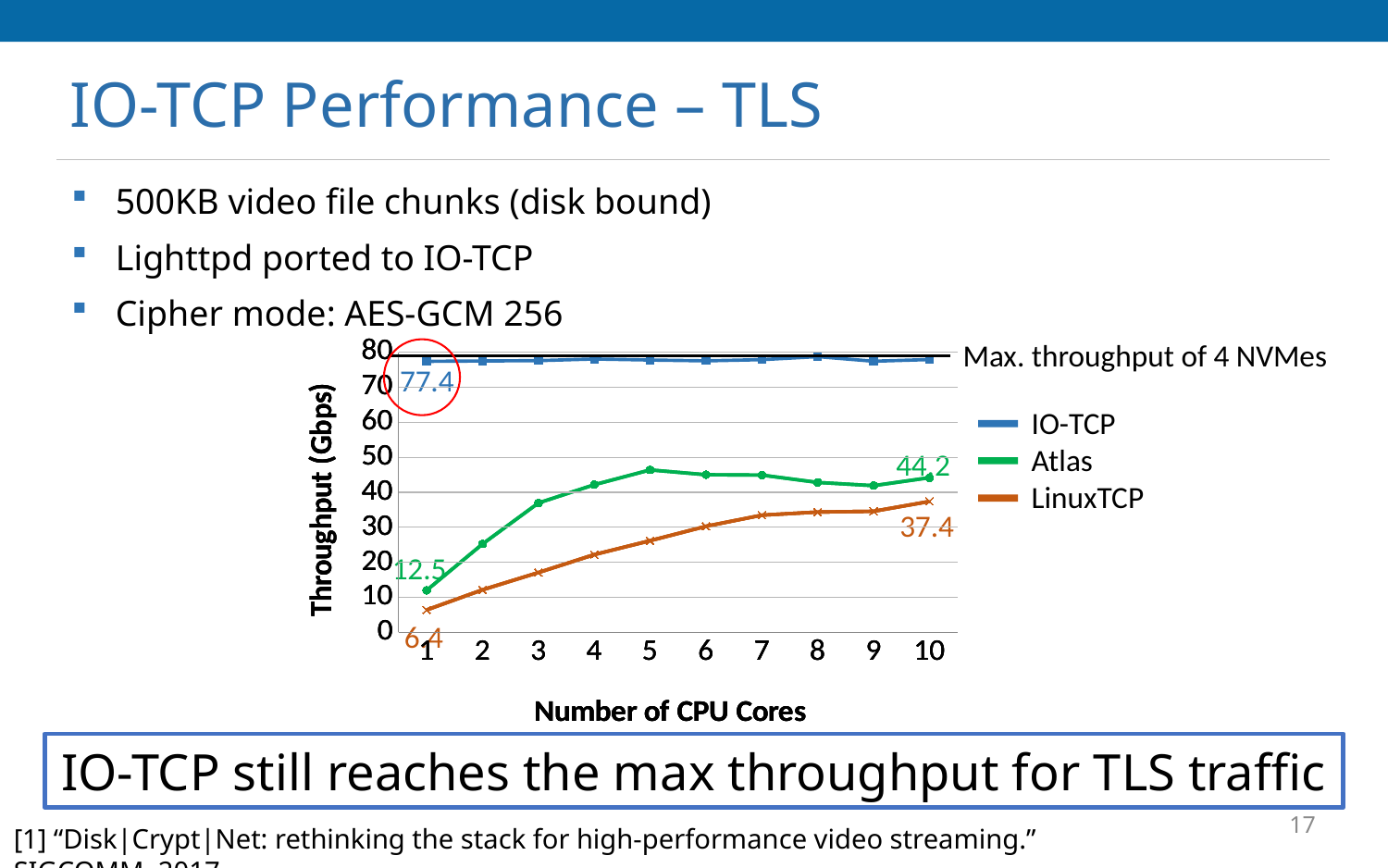
What is the throughput of Atlas at 10 CPU cores? 44.2 What kind of chart is shown on the slide? line chart What is the throughput of Atlas at 1 CPU core? 12.5 Which series has the lowest throughput at 1 CPU core? LinuxTCP How many series does the legend list? 3 What is the difference between the Atlas and LinuxTCP throughput at 10 CPU cores? 6.8 Does the LinuxTCP throughput rise or fall as the number of CPU cores increases? rise What is the throughput of LinuxTCP at 10 CPU cores? 37.4 Is the throughput of LinuxTCP at 5 CPU cores greater or less than 30? less What is the throughput of LinuxTCP at 1 CPU core? 6.4 Which series has the highest throughput across the chart? IO-TCP What is the throughput of IO-TCP at 1 CPU core? 77.4